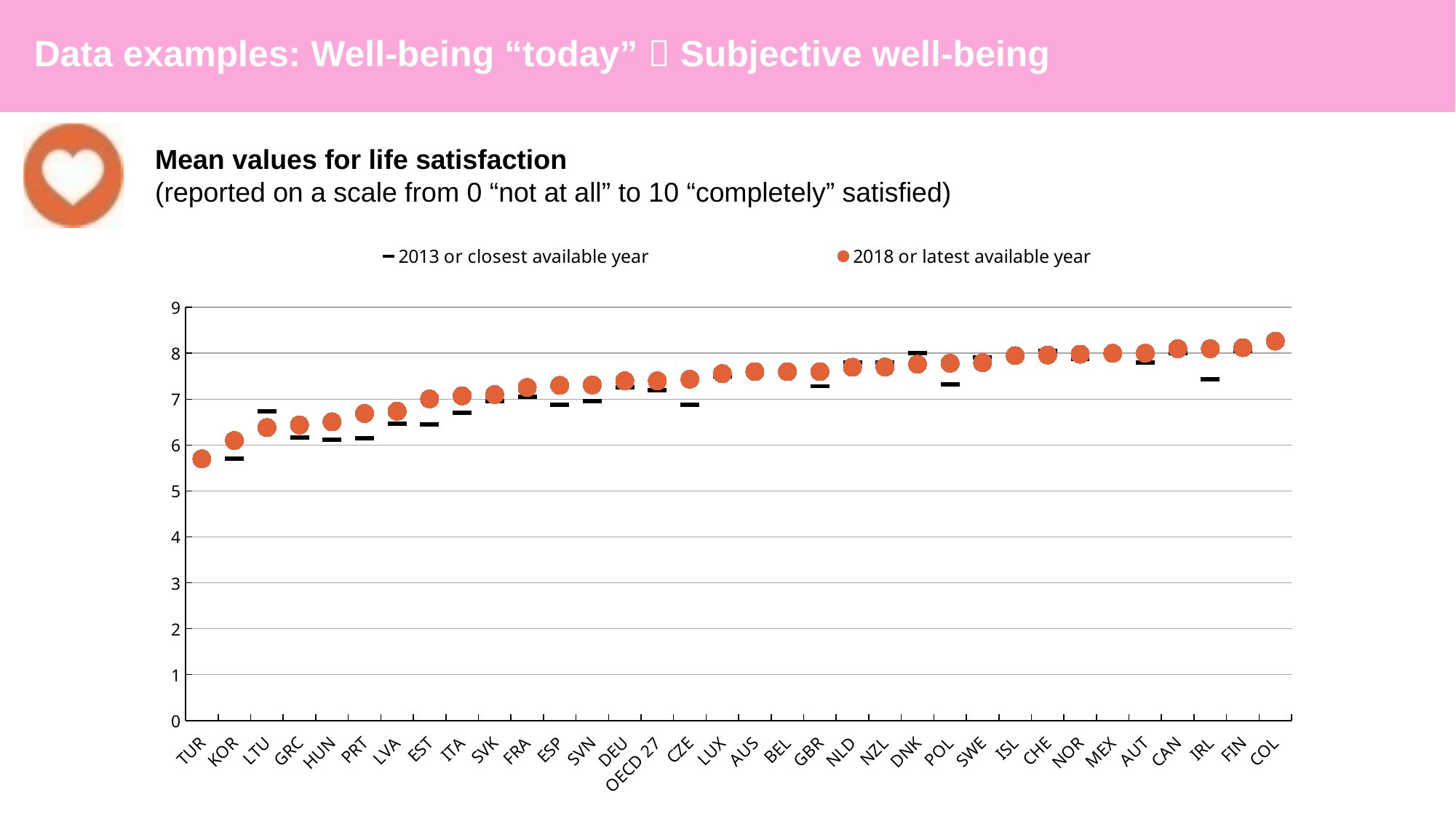
Which country has the lowest value for 2018 or latest available year? TUR For LTU, which is larger: the 2013 or closest available year value or the 2018 or latest available year value? 2013 or closest available year Is the 2013 or closest available year value for IRL greater or less than 8? less Is the 2018 or latest available year value for TUR greater or less than 6? less What colour are the markers for the 2018 or latest available year series? Orange Is the 2013 or closest available year value for CZE greater or less than 7? less Do the 2018 or latest available year values rise or fall from left to right along the x axis? rise For IRL, which is larger: the 2013 or closest available year value or the 2018 or latest available year value? 2018 or latest available year How many countries/categories are shown on the x axis? 34 How many series does the legend list? 2 Which country has the highest value for 2018 or latest available year? COL